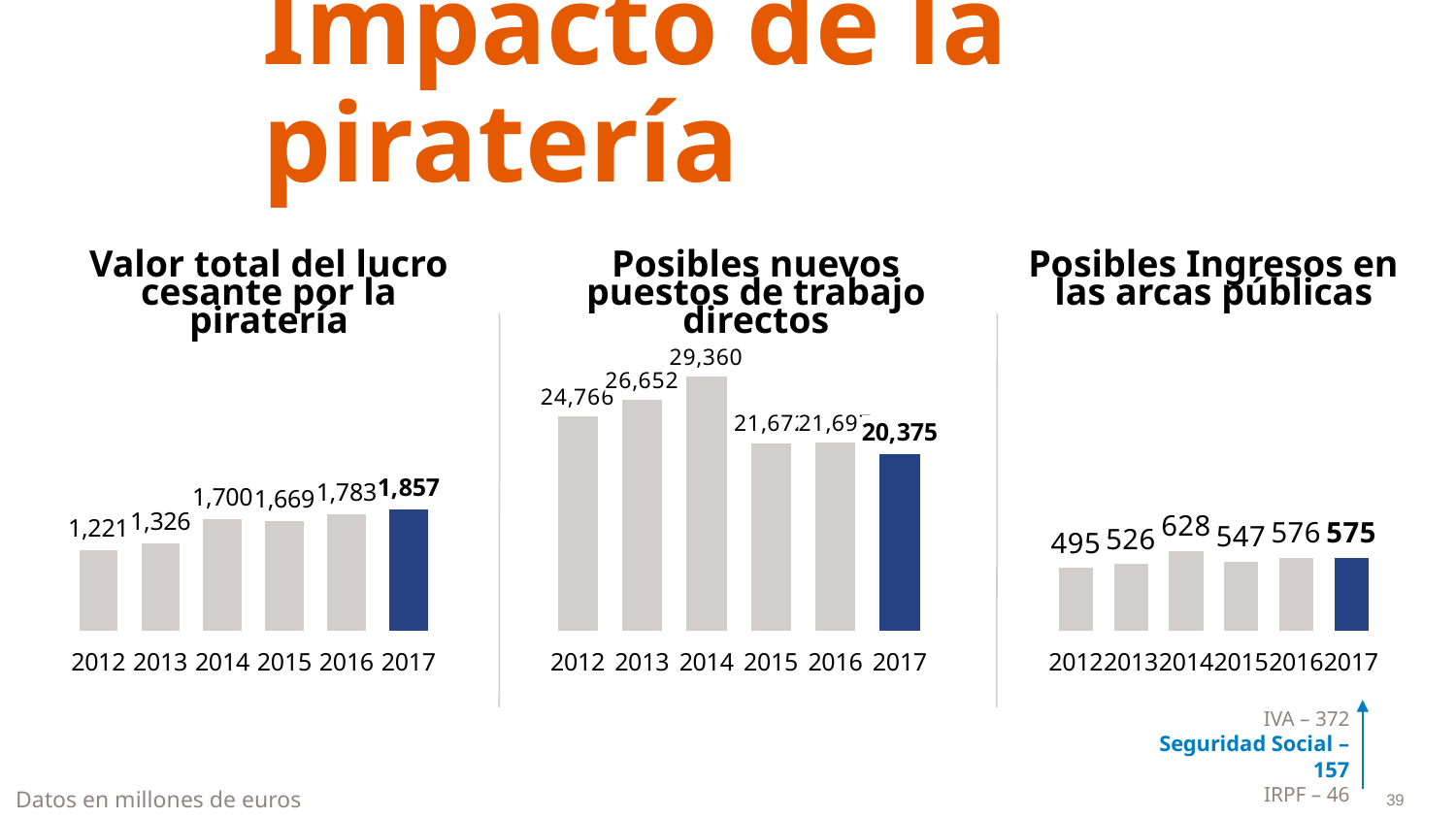
In the chart 'Posibles nuevos puestos de trabajo directos', what is the value for 2014? 29,360 What kind of chart is 'Valor total del lucro cesante por la piratería'? Bar chart In the chart 'Posibles nuevos puestos de trabajo directos', which year has the lowest value? 2017 In the chart 'Valor total del lucro cesante por la piratería', what is the value for 2017? 1,857 In the chart 'Posibles Ingresos en las arcas públicas', what is the value for 2014? 628 In the chart 'Posibles nuevos puestos de trabajo directos', what is the value for 2017? 20,375 In the chart 'Valor total del lucro cesante por la piratería', which year has the highest value? 2017 In the chart 'Posibles nuevos puestos de trabajo directos', which year has the highest value? 2014 In the chart 'Posibles Ingresos en las arcas públicas', which is larger, the value for 2013 or the value for 2015? 2015 How many years are shown on the x axis of the chart 'Posibles Ingresos en las arcas públicas'? 6 In the chart 'Valor total del lucro cesante por la piratería', what is the value for 2012? 1,221 In the chart 'Valor total del lucro cesante por la piratería', what is the difference between the 2017 and 2012 values? 636